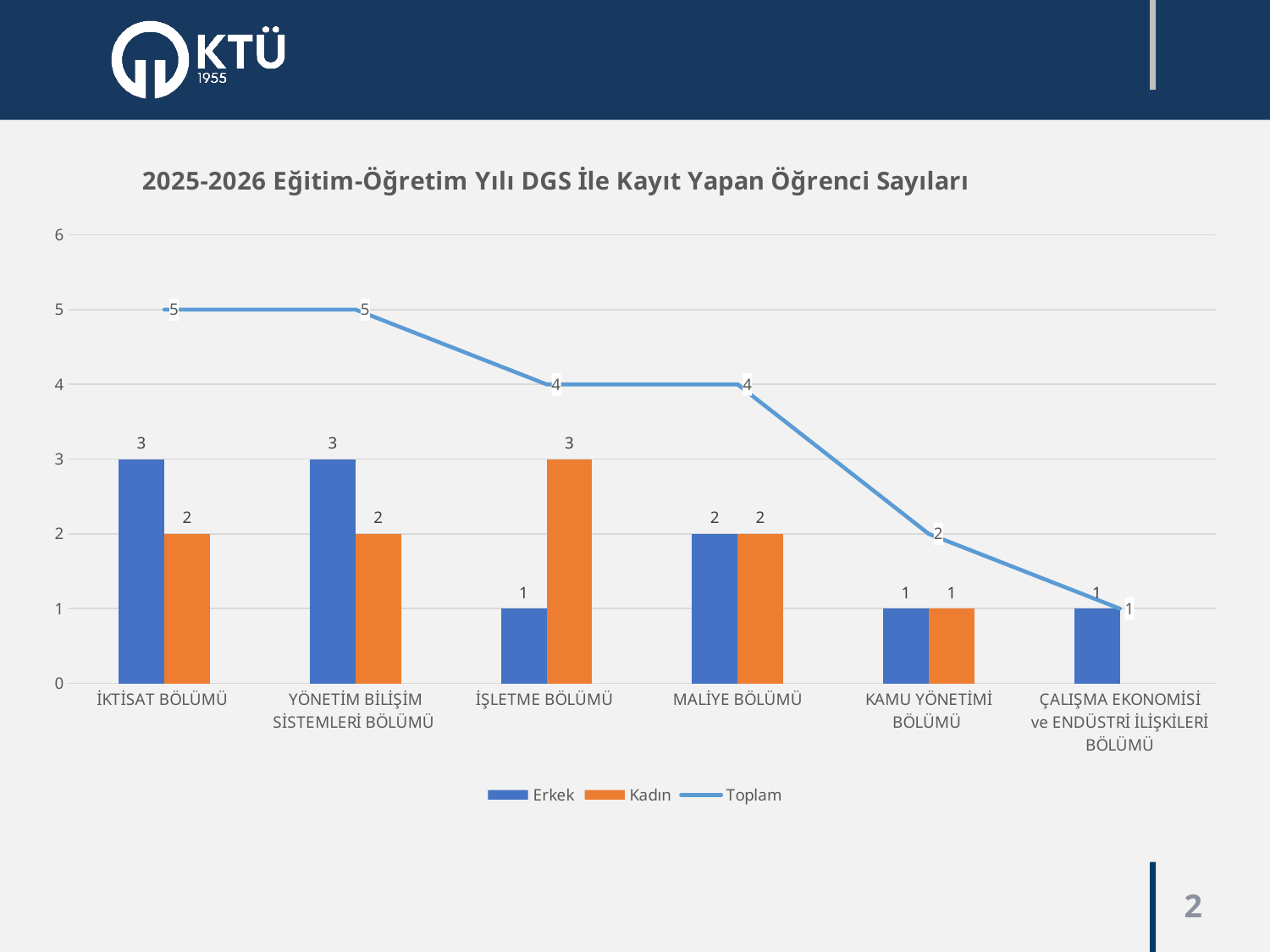
What is the title of the chart? 2025-2026 Eğitim-Öğretim Yılı DGS İle Kayıt Yapan Öğrenci Sayıları Does the Toplam line rise or fall from left to right across the departments? Falls What is the Kadın value for İŞLETME BÖLÜMÜ? 3 Which is larger for İŞLETME BÖLÜMÜ, the Erkek value or the Kadın value? Kadın What is the difference between the Toplam values for İKTİSAT BÖLÜMÜ and KAMU YÖNETİMİ BÖLÜMÜ? 3 What is the Toplam value for MALİYE BÖLÜMÜ? 4 Which department has the lowest Toplam value? ÇALIŞMA EKONOMİSİ ve ENDÜSTRİ İLİŞKİLERİ BÖLÜMÜ Which department has the highest Kadın value? İŞLETME BÖLÜMÜ What is the Toplam value for KAMU YÖNETİMİ BÖLÜMÜ? 2 How many departments are shown on the x axis? 6 What is the Erkek value for İKTİSAT BÖLÜMÜ? 3 How many series does the legend list? 3